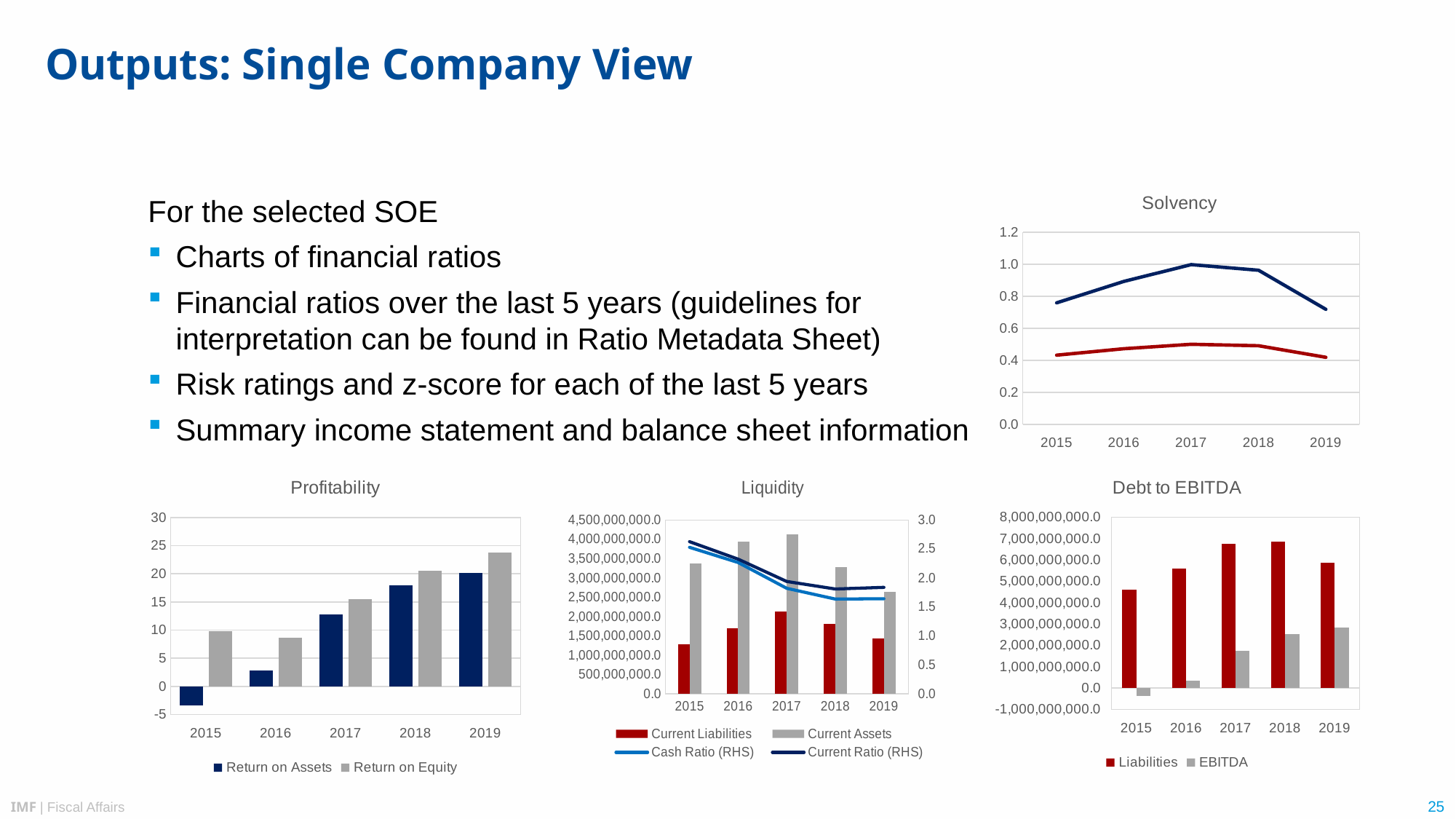
In the Profitability chart, which year has the highest Return on Equity? 2019 What kind of chart is the Profitability chart? bar chart In the Profitability chart, is the Return on Assets value for 2019 greater or less than 15? greater In the Liquidity chart, is the Current Liabilities value for 2015 greater or less than 1,500,000,000.0? less In the Profitability chart, does Return on Assets rise or fall from 2015 to 2019? rise How many years are shown on the x axis of the Solvency chart? 5 In the Debt to EBITDA chart, is the Liabilities value for 2016 greater or less than 5,000,000,000.0? greater In the Liquidity chart, does the Current Ratio (RHS) line rise or fall from 2015 to 2019? fall In the Liquidity chart, which year has the highest Current Assets? 2017 In the Debt to EBITDA chart, which year has the lowest EBITDA? 2015 In the Profitability chart, which year has the lowest Return on Assets? 2015 How many series does the legend of the Liquidity chart list? 4